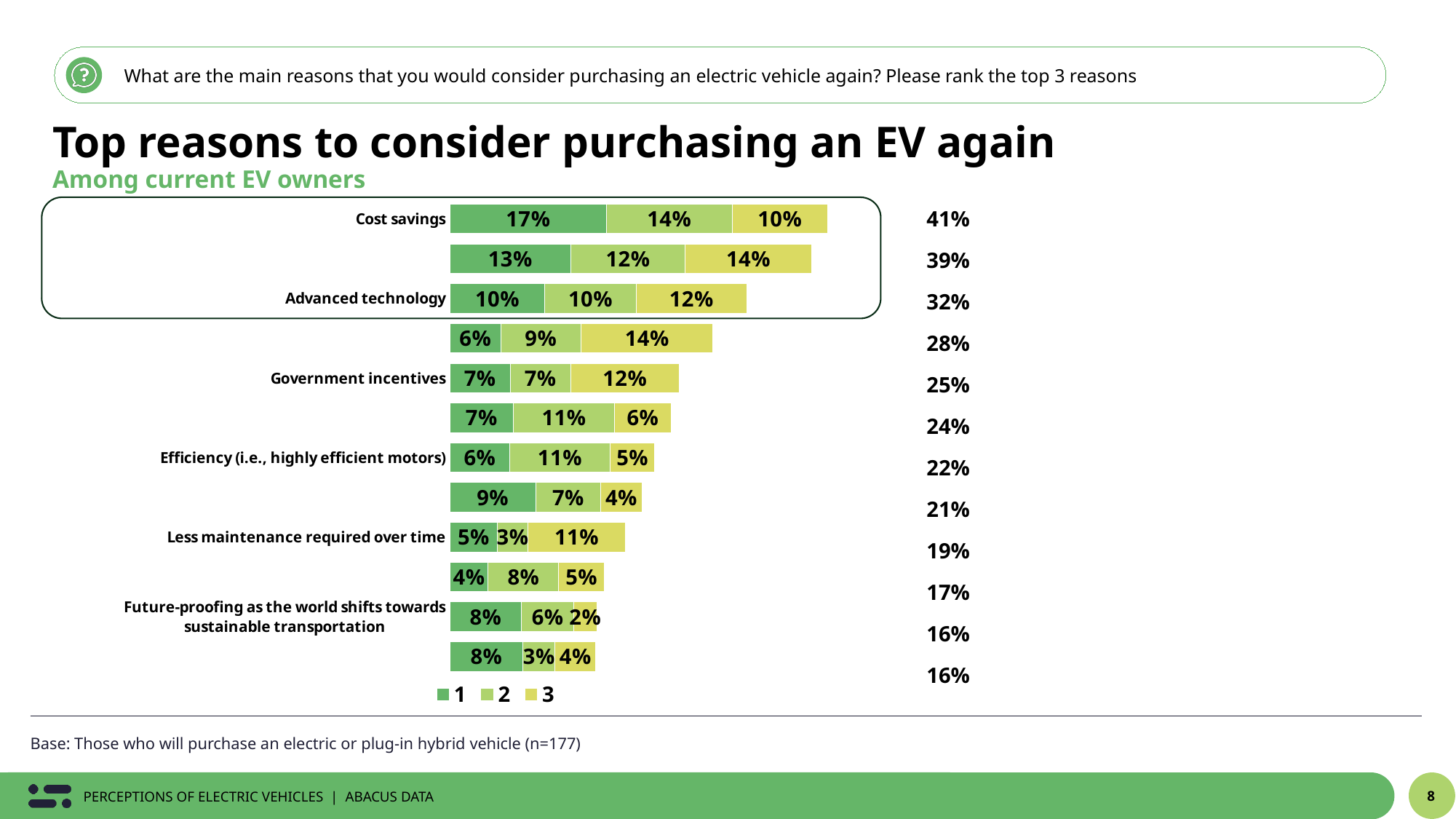
Which reason has the highest total percentage? Cost savings What percentage of respondents ranked Cost savings as their number 1 reason? 17% What type of chart is shown on the slide? Stacked bar chart How many bars are plotted in the chart? 12 What is the total percentage shown for Cost savings? 41% What percentage ranked Future-proofing as the world shifts towards sustainable transportation as reason number 1? 8% How many percentage points higher is the rank 1 value for Cost savings than the rank 1 value for Advanced technology? 7 percentage points What is the total percentage shown for Efficiency (i.e., highly efficient motors)? 22% What percentage ranked Advanced technology as reason number 3? 12% How many series does the legend list? 3 Which has a larger rank 3 value: Government incentives or Efficiency (i.e., highly efficient motors)? Government incentives What percentage ranked Less maintenance required over time as reason number 2? 3%